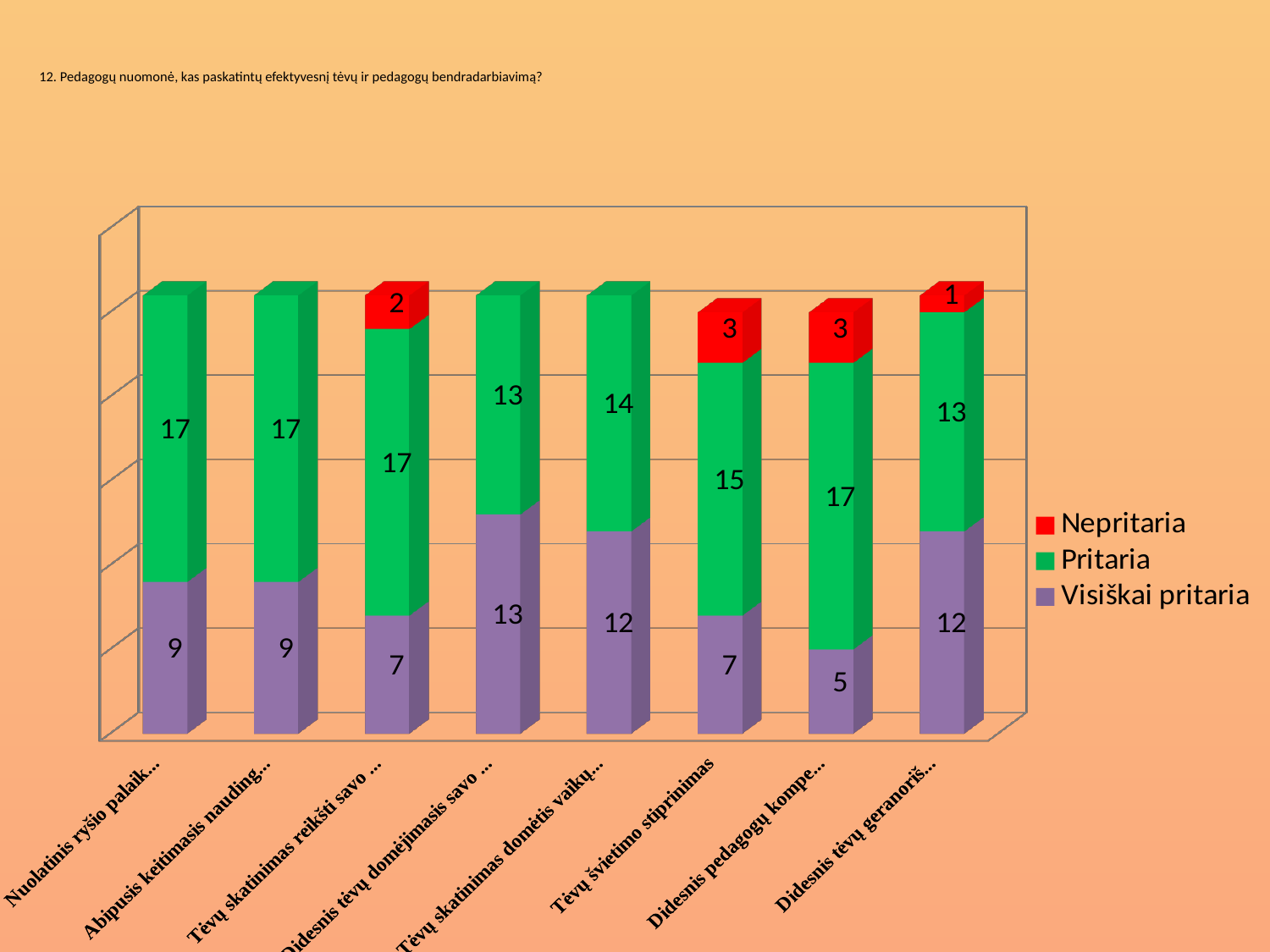
What is the Visiškai pritaria value for the category beginning "Didesnis pedagogų kompe..."? 5 Which has the larger Visiškai pritaria value: "Tėvų švietimo stiprinimas" or the category beginning "Didesnis tėvų geranoriš..."? Didesnis tėvų geranoriš... What is the Pritaria value for the category beginning "Tėvų skatinimas domėtis vaikų..."? 14 What is the Pritaria value for the category "Tėvų švietimo stiprinimas"? 15 For the category beginning "Didesnis pedagogų kompe...", what is the difference between the Pritaria value and the Visiškai pritaria value? 12 Which category has the highest Visiškai pritaria value? Didesnis tėvų domėjimasis savo ... Which category has the lowest Visiškai pritaria value? Didesnis pedagogų kompe... What is the Nepritaria value for the category beginning "Didesnis tėvų geranoriš..."? 1 What is the total of the stacked bar for "Tėvų švietimo stiprinimas"? 25 What kind of chart is shown on the slide? Stacked bar chart How many categories (bars) are plotted in the chart? 8 How many series does the legend list? 3